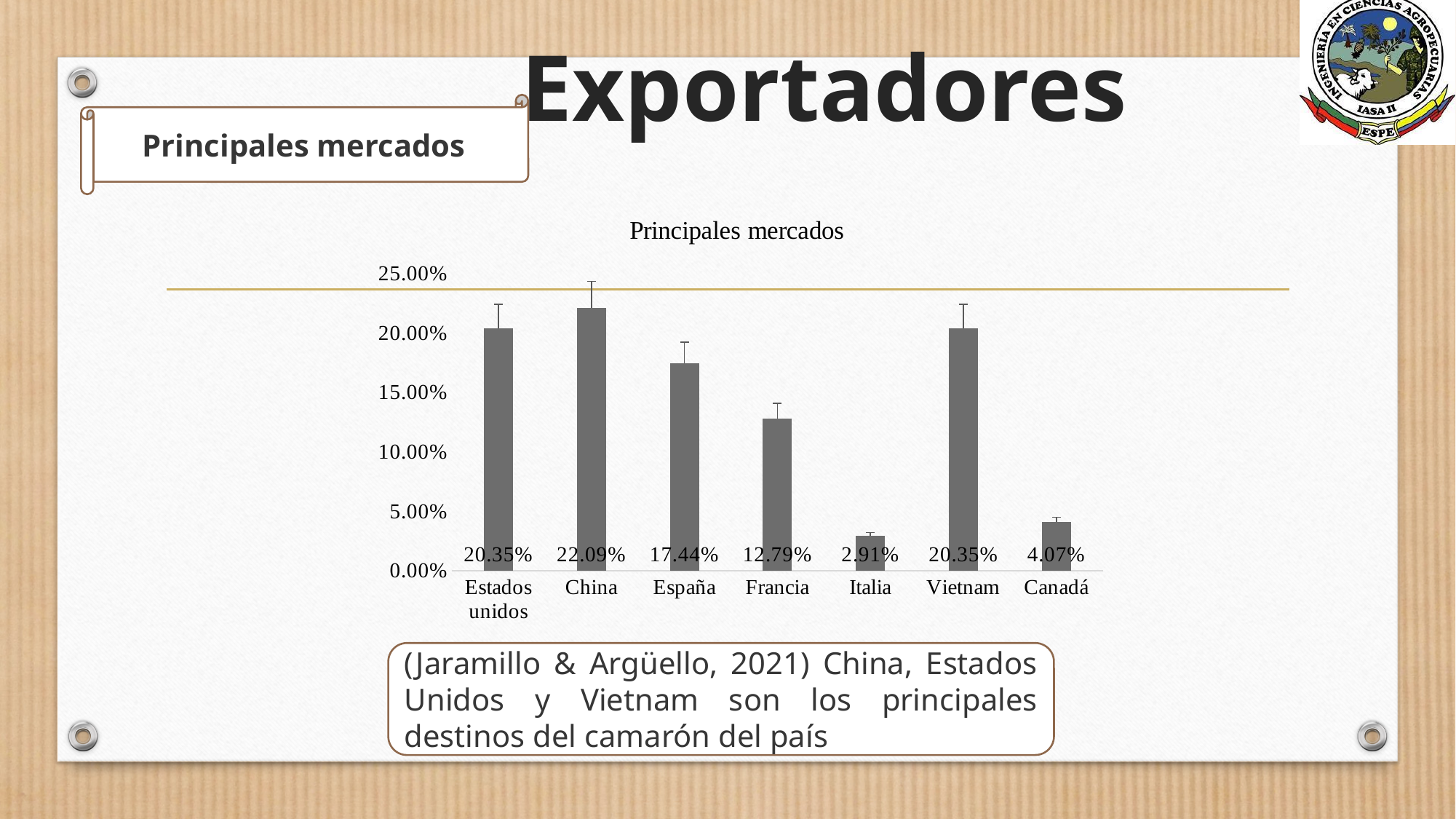
Which market has the highest value in the Principales mercados chart? China How many markets are shown in the Principales mercados chart? 7 What is the difference between the values for China and España in the Principales mercados chart? 4.65% What is the value for China in the Principales mercados chart? 22.09% What is the difference between the values for Canadá and Italia in the Principales mercados chart? 1.16% Which market has the lowest value in the Principales mercados chart? Italia What is the value for España in the Principales mercados chart? 17.44% What is the title of the chart on the slide? Principales mercados Which is larger in the Principales mercados chart, the value for Francia or the value for Vietnam? Vietnam What is the value for Canadá in the Principales mercados chart? 4.07% What is the value for Francia in the Principales mercados chart? 12.79% What kind of chart is the Principales mercados chart? Bar chart